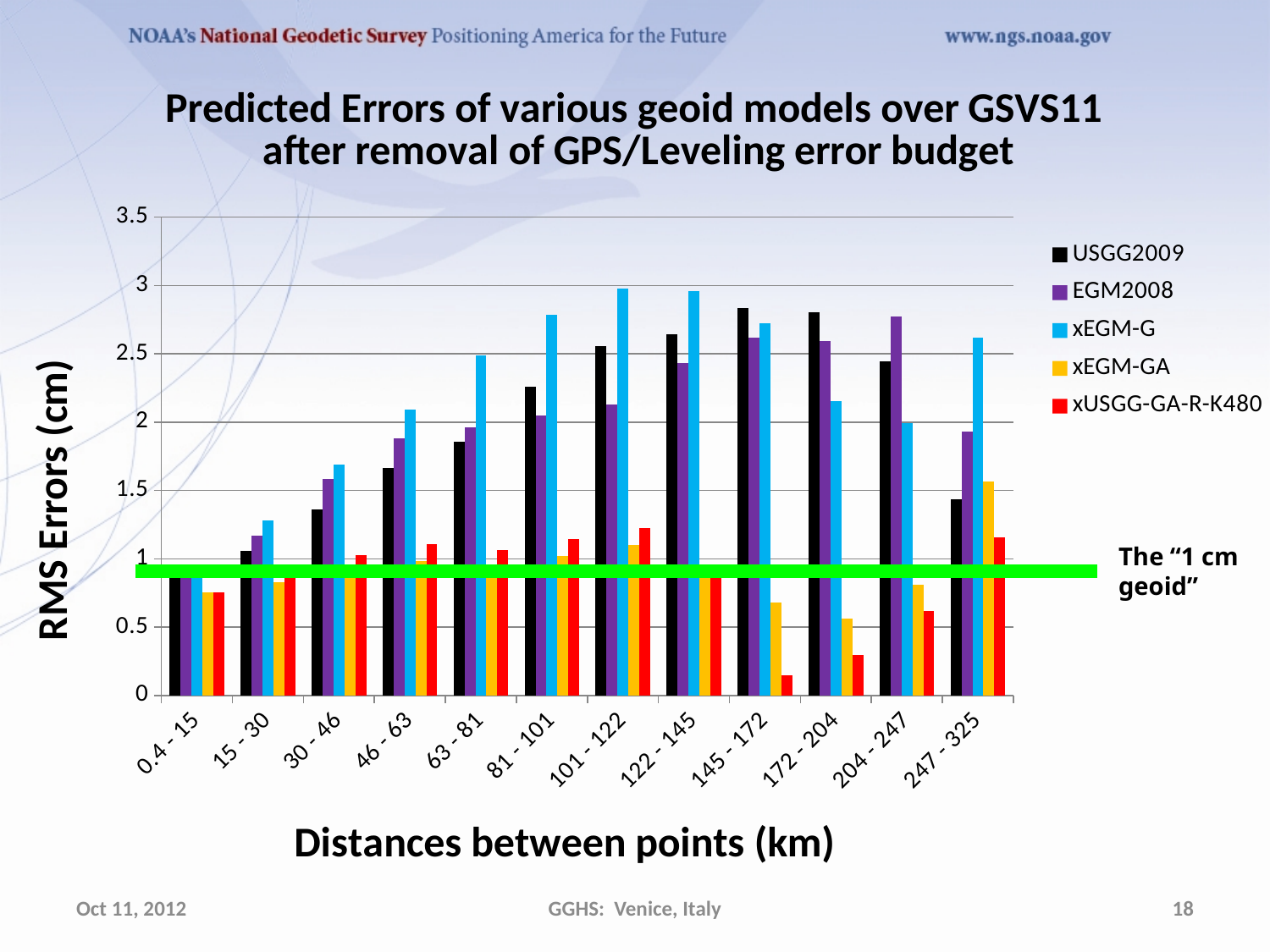
What label is given to the green horizontal line on the chart? The "1 cm geoid" How many series does the legend list? 5 Is the value for xUSGG-GA-R-K480 in the 145 - 172 km category greater or less than 0.5? less Do the USGG2009 values rise or fall from the 0.4 - 15 km category to the 145 - 172 km category? rise Is the value for EGM2008 in the 204 - 247 km category greater or less than 2.5? greater Which series has the highest value in the 101 - 122 km category? xEGM-G Is the value for xEGM-G in the 101 - 122 km category greater or less than 2.5? greater In which distance category is the xUSGG-GA-R-K480 value lowest? 145 - 172 In the 172 - 204 km category, which is larger: USGG2009 or xEGM-G? USGG2009 How many distance categories are shown on the x axis? 12 What kind of chart is shown on the slide? bar chart